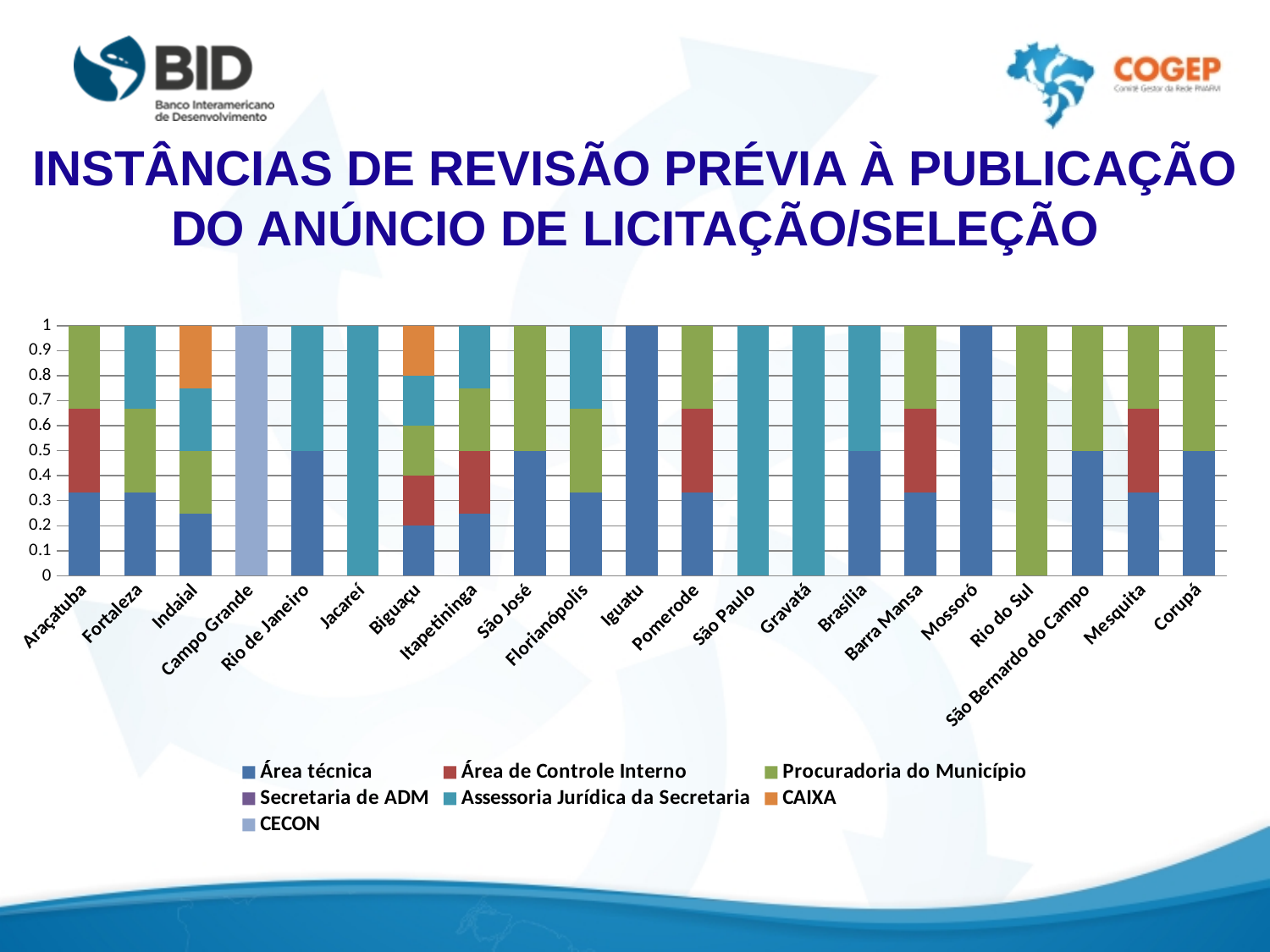
What kind of chart is shown on the slide? stacked bar chart How many series does the chart's legend list? 7 Which city's bar is made up entirely of the CECON series? Campo Grande How many cities are shown along the x axis of the chart? 21 What is the value of Área técnica for Iguatu? 1 Which series is shown in orange in the legend? CAIXA What is the value of Área técnica for Rio de Janeiro? 0.5 Is the value of Assessoria Jurídica da Secretaria for Jacareí greater or less than 0.9? greater What is the total height of the stacked bar for Fortaleza? 1 Which is larger, the Área técnica value for Mossoró or for Indaial? Mossoró What is the value of Área técnica for Biguaçu? 0.2 Is the value of Área técnica for Araçatuba greater or less than 0.5? less